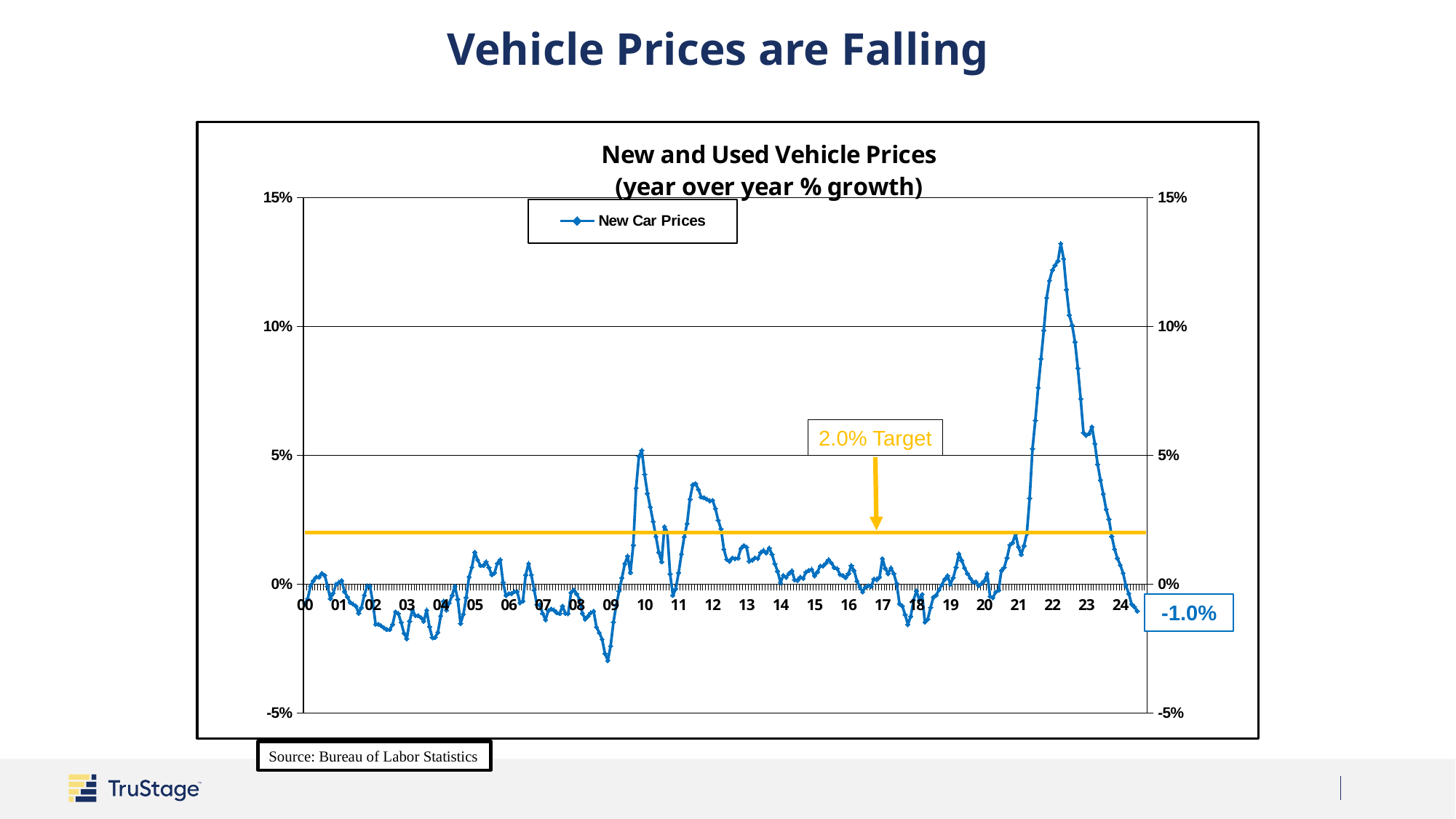
How many year labels are shown on the x axis? 25 How many series does the legend list? 1 Does New Car Prices growth rise or fall from 2022 to 2024? Fall What is the title of the chart? New and Used Vehicle Prices (year over year % growth) In which year does New Car Prices growth reach its highest point? 22 What is the name of the series shown in the legend? New Car Prices What is the most recent value shown for New Car Prices on the chart? -1.0% Which is larger: the peak of New Car Prices around 2010 or the peak around 2022? 2022 What target level is marked by the horizontal line on the chart? 2.0% Target Is the lowest value for New Car Prices in 2009 greater or less than 0%? less Is the peak value for New Car Prices in 2022 greater or less than 10%? greater What kind of chart is shown on the slide? Line chart